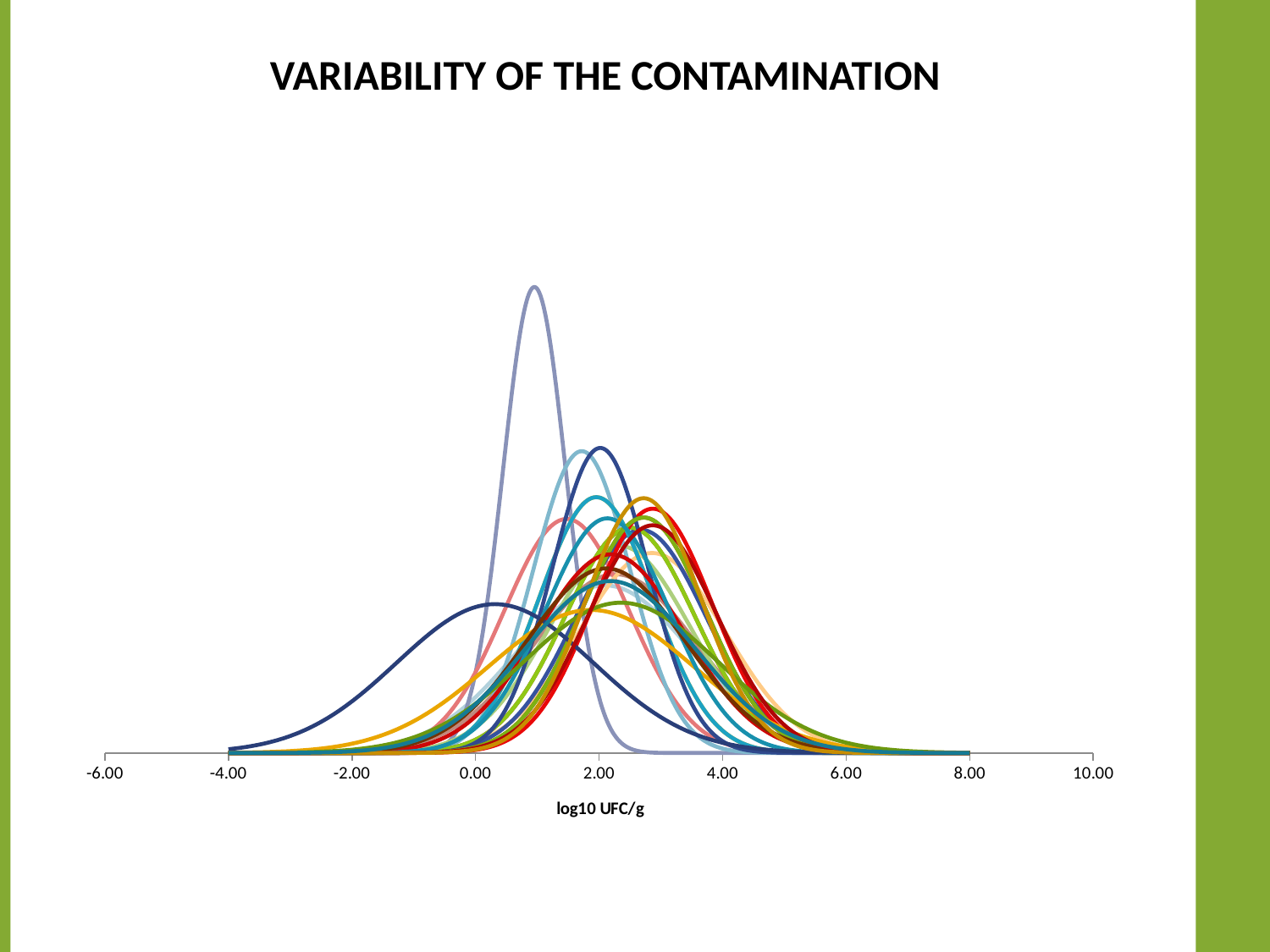
Is the x position of the peak of the widest dark blue curve greater or less than 2.00? less Does the chart show a legend identifying the curves? No What is the title of the chart on the slide? VARIABILITY OF THE CONTAMINATION How many tick labels are shown on the x axis? 9 What kind of chart is shown on the slide? line chart What is the label of the x axis? log10 UFC/g Is the x position of the peak of the bold red curve greater or less than 2.00? greater What is the lowest value labelled on the x axis? -6.00 Is the x position of the tallest peak (the narrow light purple curve) greater or less than 2.00? less What is the highest value labelled on the x axis? 10.00